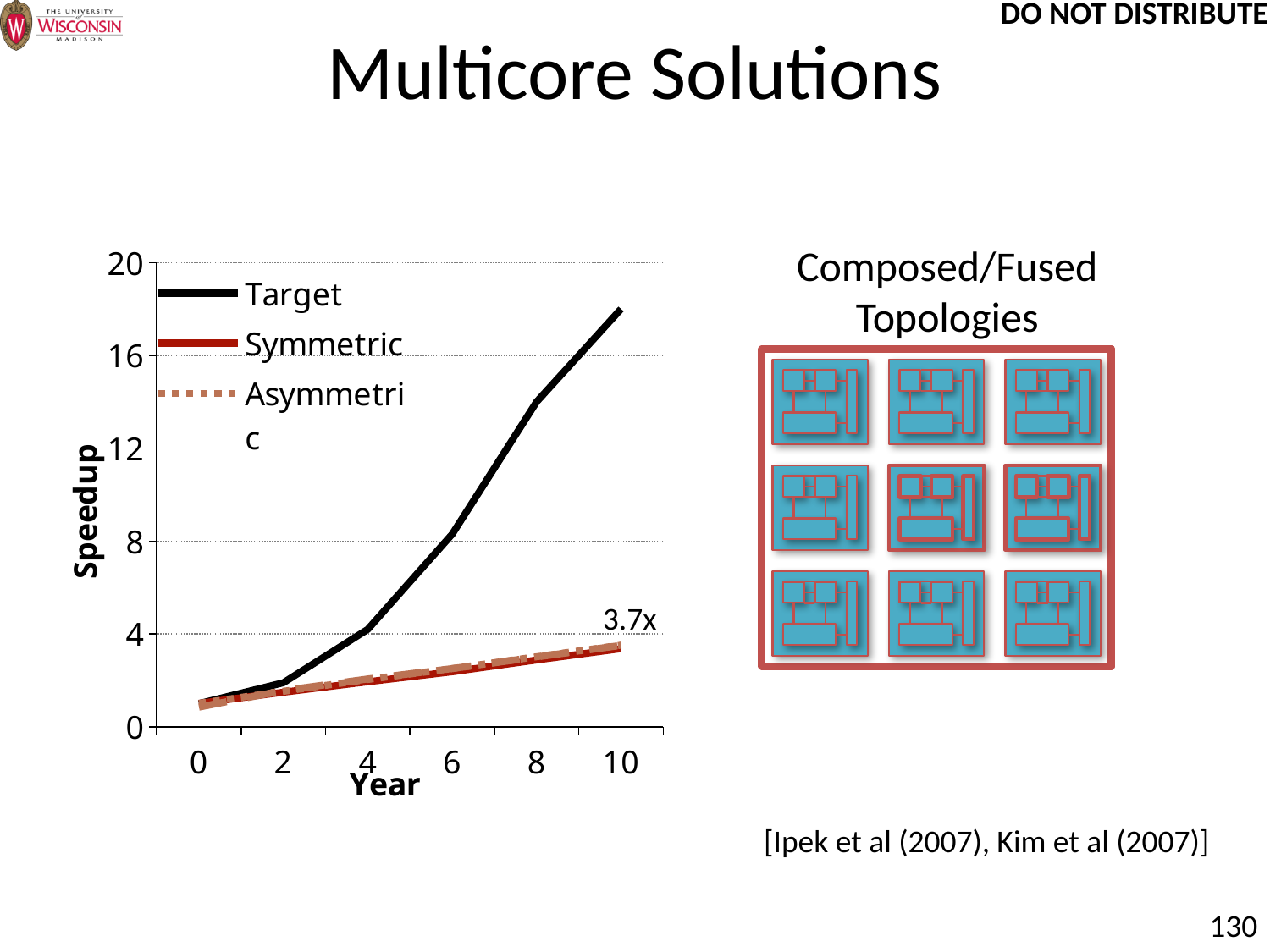
Which series reaches the highest speedup at year 10? Target How many series does the chart's legend list? 3 What are the three series named in the chart's legend? Target, Symmetric, Asymmetric At year 10, which series has the higher speedup, Target or Symmetric? Target What kind of chart is shown on the slide? line chart What data label is printed near the end of the Symmetric and Asymmetric lines at year 10? 3.7x Is the value of the Symmetric series at year 10 greater or less than 4? less Does the Target series rise or fall as Year increases? rise What is the label on the chart's vertical axis? Speedup Is the value of the Target series at year 8 greater or less than 12? greater Is the value of the Target series at year 10 greater or less than 16? greater